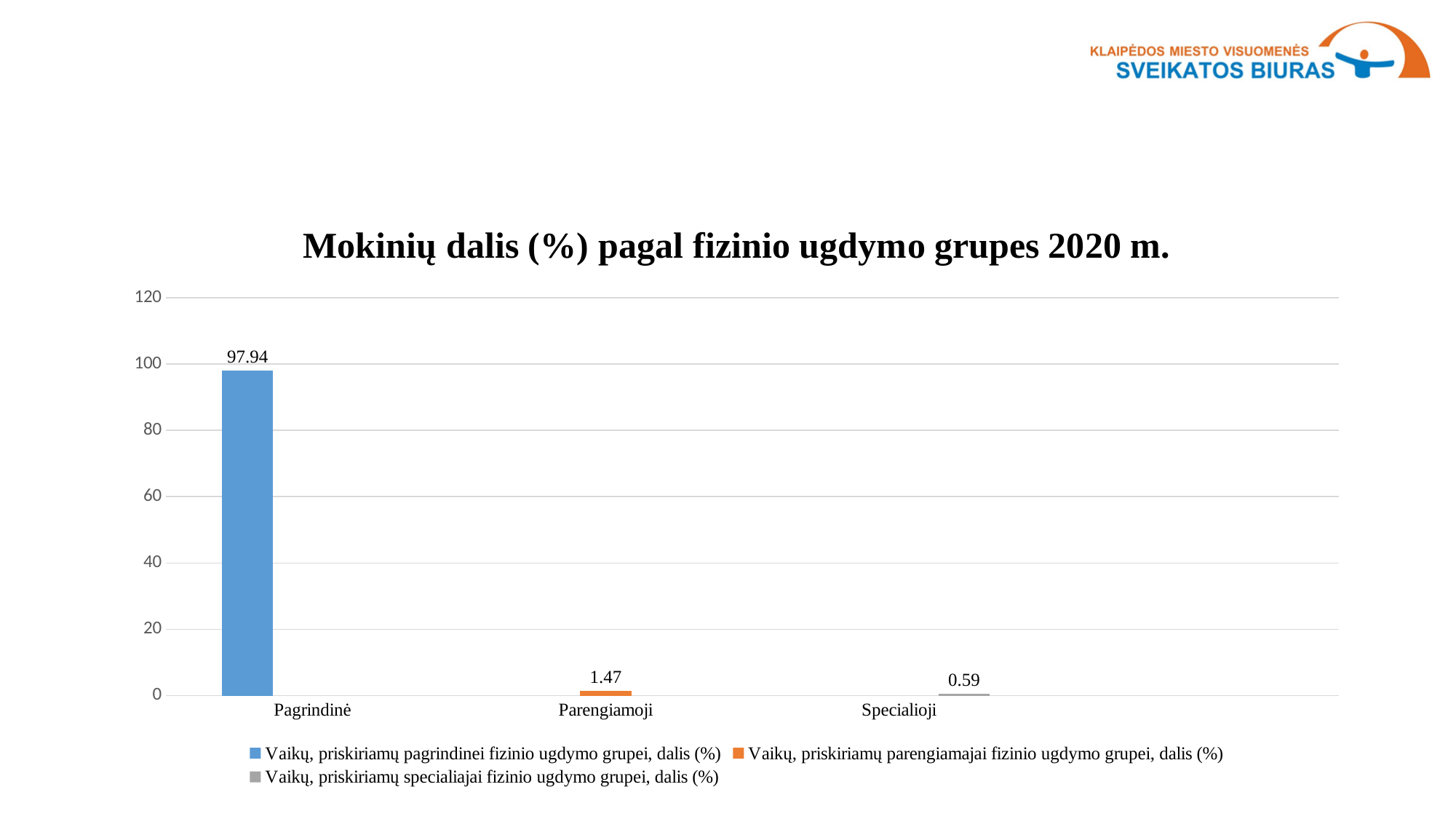
What is the difference between the values for Parengiamoji and Specialioji? 0.88 What is the value for Parengiamoji? 1.47 Which category has the highest value? Pagrindinė Which is larger, the value for Parengiamoji or the value for Specialioji? Parengiamoji Is the value for Pagrindinė greater or less than 80? greater What kind of chart is shown on the slide? bar chart What is the difference between the values for Pagrindinė and Parengiamoji? 96.47 How many categories are shown on the x axis? 3 What is the value for Specialioji? 0.59 How many series does the legend list? 3 What is the value for Pagrindinė? 97.94 Which category has the lowest value? Specialioji